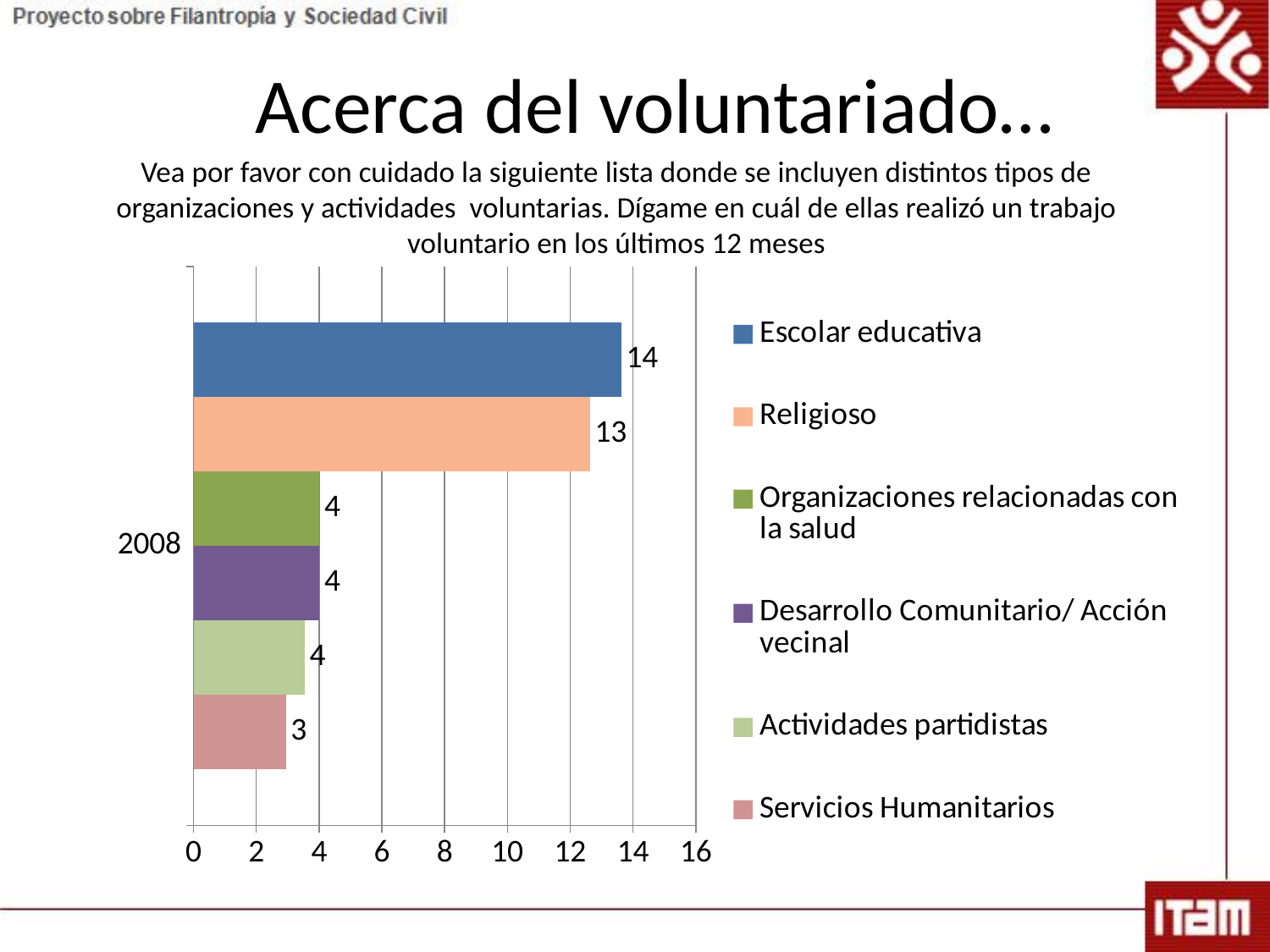
What is the difference between the values for Religioso and Servicios Humanitarios? 10 What is the value for Religioso in 2008? 13 What is the value for Servicios Humanitarios in 2008? 3 Which year is shown as the category on the vertical axis? 2008 What is the value for Escolar educativa in 2008? 14 Which series has the lowest value in 2008? Servicios Humanitarios What is the difference between the values for Escolar educativa and Religioso? 1 Which series has the highest value in 2008? Escolar educativa What is the value for Actividades partidistas in 2008? 4 Which is larger, the value for Religioso or the value for Desarrollo Comunitario/ Acción vecinal? Religioso How many series does the legend list? 6 What kind of chart is shown on the slide? Bar chart